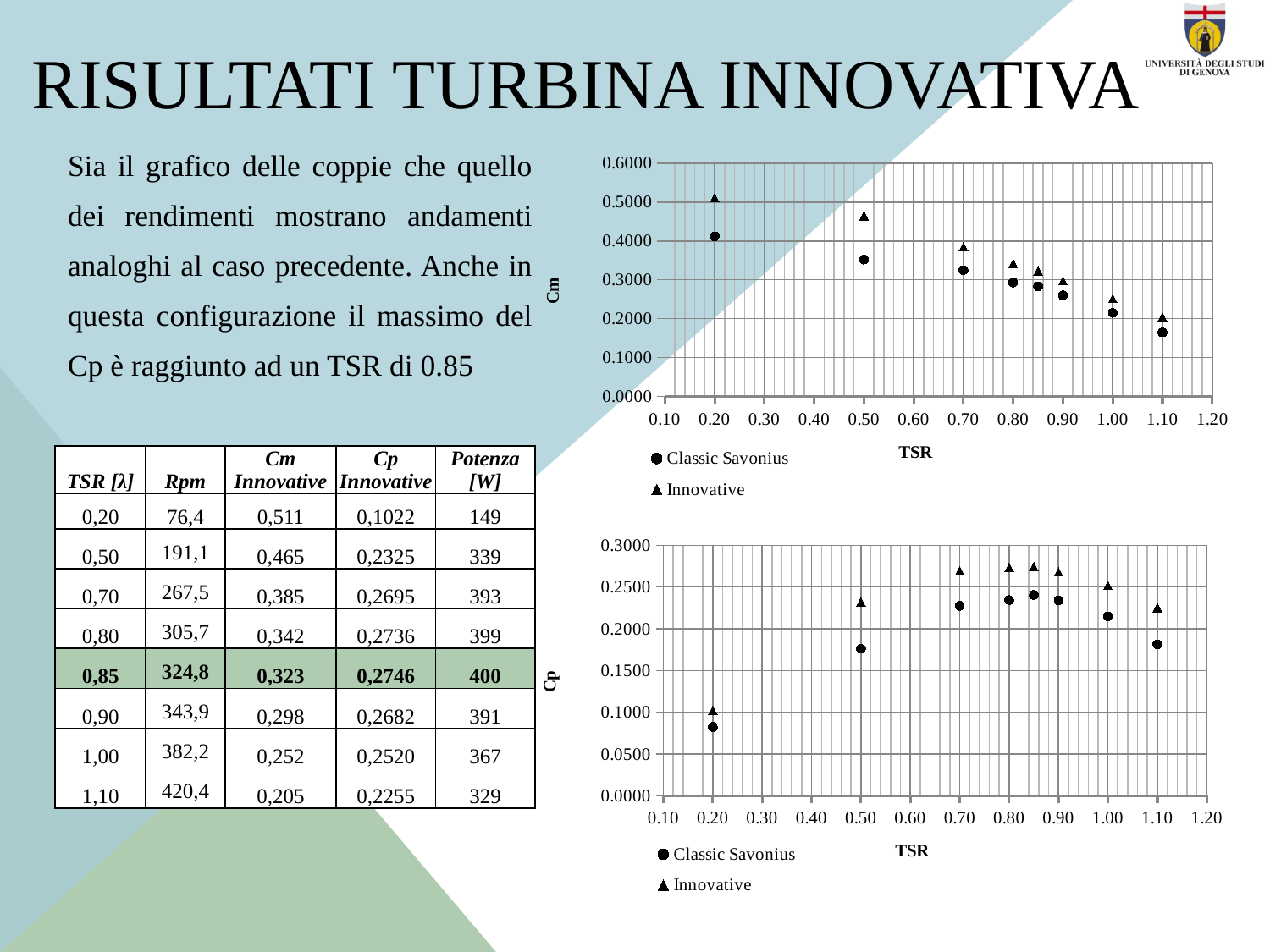
In the bottom chart (Cp vs TSR), is the Classic Savonius value at TSR 0.20 greater or less than 0.1000? less In the top chart (Cm vs TSR), is the Classic Savonius value at TSR 1.10 greater or less than 0.2000? less In the top chart (Cm vs TSR), at which TSR is the Classic Savonius series lowest? 1.10 In the top chart (Cm vs TSR), do the Innovative values rise or fall as TSR increases? fall In the top chart (Cm vs TSR), at which TSR is the Innovative series highest? 0.20 In the bottom chart (Cp vs TSR), which marker shape is used for the Innovative series? triangle In the bottom chart (Cp vs TSR), is the Innovative value at TSR 0.85 greater or less than 0.2500? greater In the top chart (Cm vs TSR), which series has the higher value at TSR 0.50, Classic Savonius or Innovative? Innovative In the top chart (Cm vs TSR), how many data points are plotted for the Innovative series? 8 What type of chart is the top chart (Cm vs TSR)? scatter chart How many series does the legend of the top chart (Cm vs TSR) list? 2